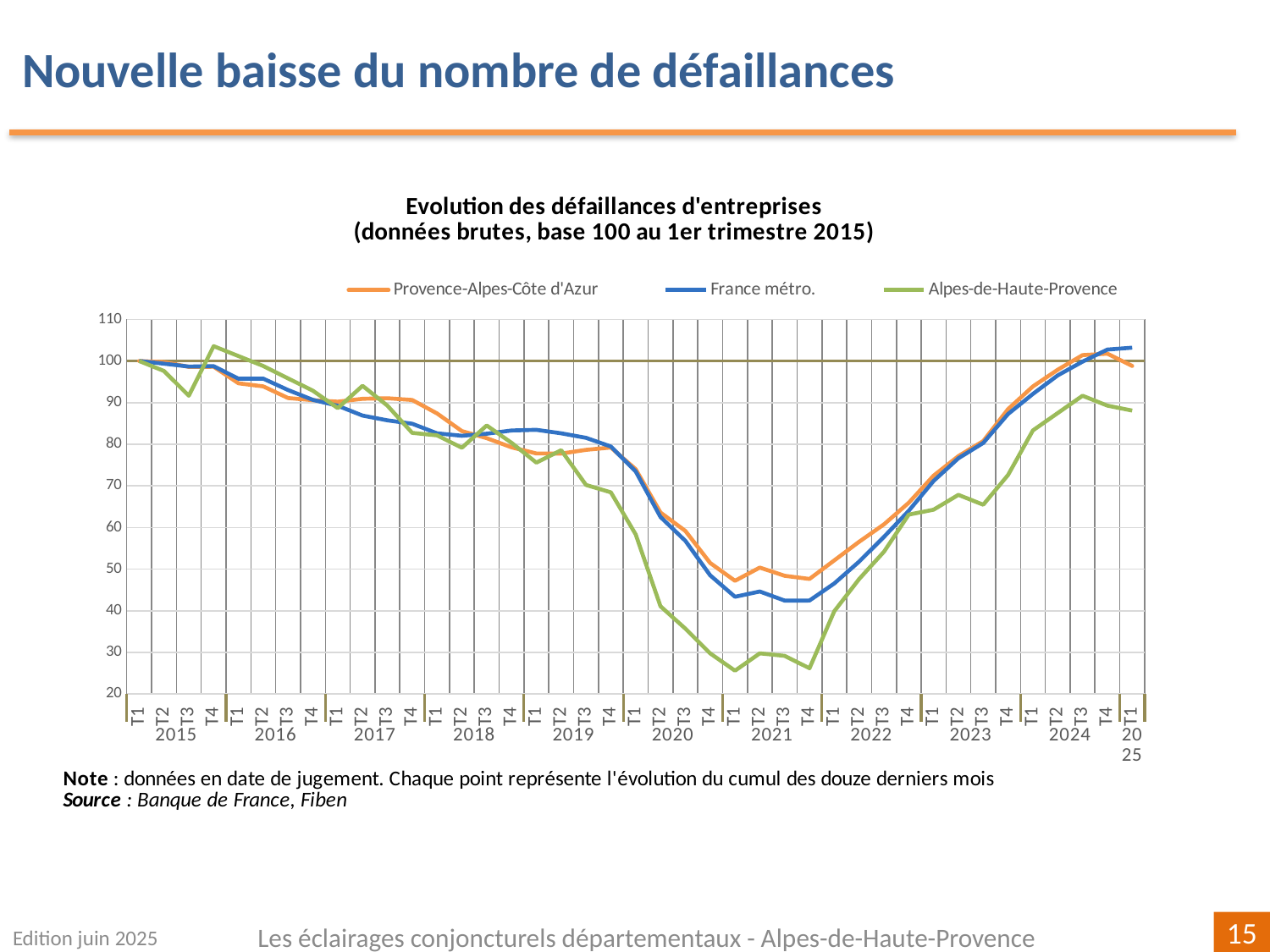
What kind of chart is shown on the slide? line chart How many series does the legend list? 3 What colour is the line for Alpes-de-Haute-Provence? green Is the value for Alpes-de-Haute-Provence at T1 2025 greater or less than 90? less Is the value for France métro. at T1 2025 greater or less than 100? greater What is the value of the France métro. series at T1 2015? 100 Is the value for Alpes-de-Haute-Provence at T1 2021 greater or less than 30? less At T1 2025, which is larger: France métro. or Alpes-de-Haute-Provence? France métro. Which series has the lowest value at T1 2021? Alpes-de-Haute-Provence Does the Alpes-de-Haute-Provence series rise or fall between T1 2019 and T1 2021? fall Does the Provence-Alpes-Côte d'Azur series rise or fall between T1 2022 and T3 2024? rise